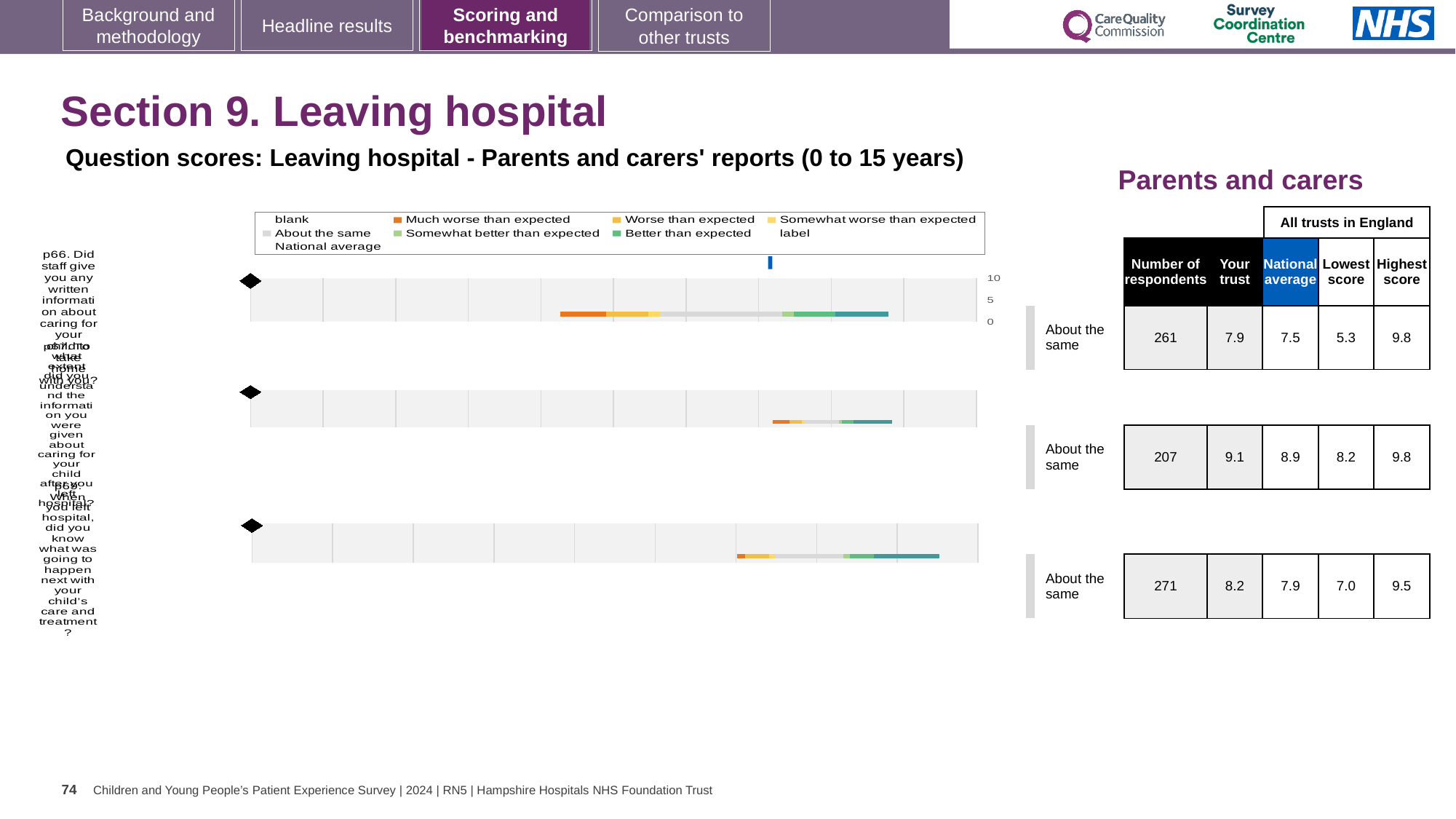
For the top bar (p66), which is larger: the 'Your trust' score or the national average? Your trust For the top bar (p66), what is the 'Your trust' score shown in the table? 7.9 What colour represents 'Better than expected' in the legend? teal For the top bar (p66), how many respondents are shown? 261 How many entries does the chart legend list? 9 What kind of chart is used to show the question scores on this slide? bar chart For the bottom bar (p68), what is the national average score? 7.9 What colour represents 'Much worse than expected' in the legend? orange Which bar has the highest 'Your trust' score? the middle bar (9.1) How many question bars are plotted on the slide? 3 For the bottom bar (p68), what is the difference between the 'Your trust' score and the national average? 0.3 For the middle bar, what is the highest score across all trusts in England? 9.8